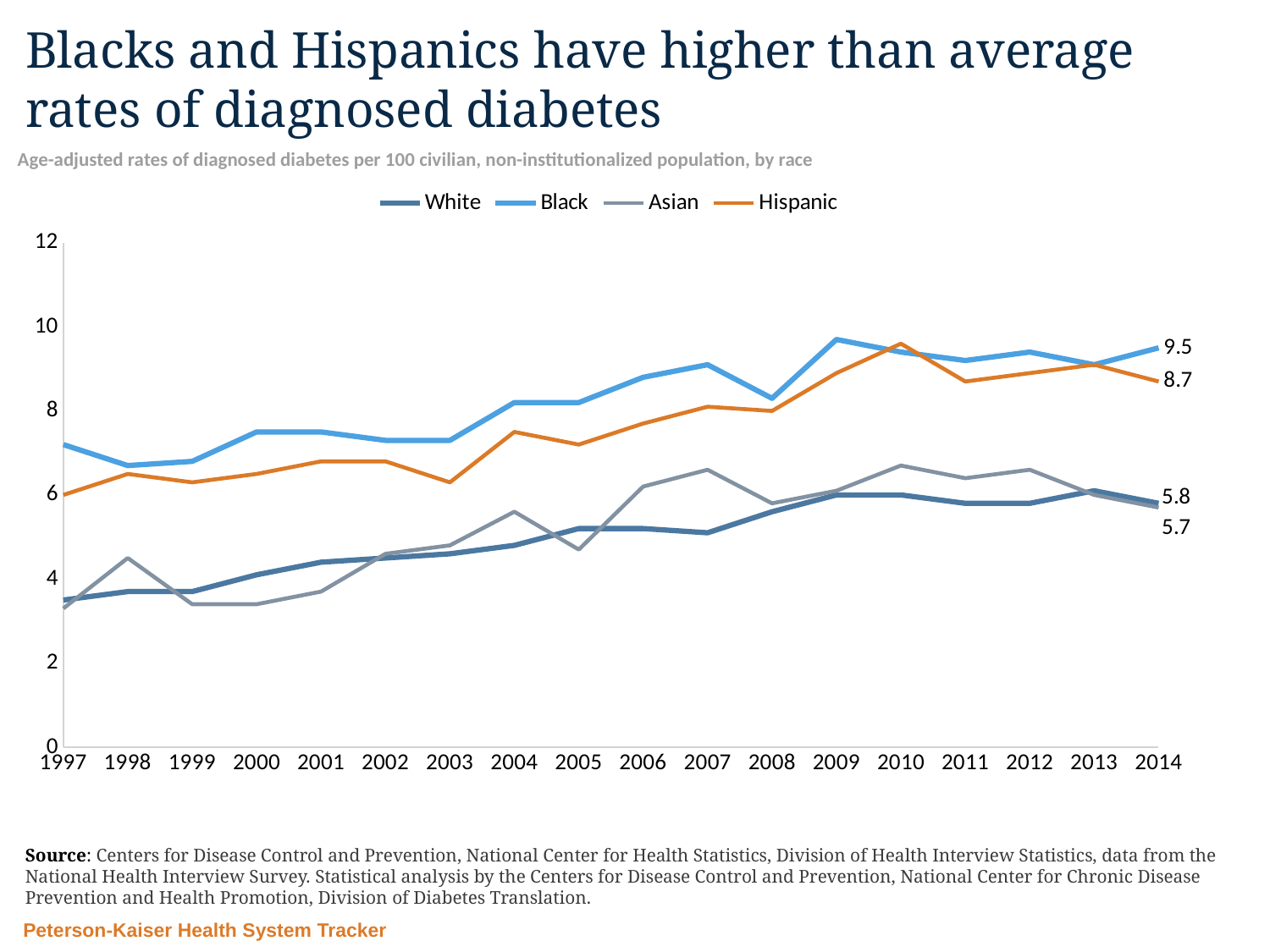
What kind of chart is shown on the slide? line chart What is the difference between the Black and Hispanic rates in 2014? 0.8 What is the rate of diagnosed diabetes for White in 2014? 5.8 What is the rate of diagnosed diabetes for Black in 2014? 9.5 What is the rate of diagnosed diabetes for Hispanic in 2014? 8.7 Is the value for White in 1997 greater or less than 4? less How many years are plotted along the x axis? 18 In 2014, which is larger, the rate for Black or the rate for Hispanic? Black Does the White line generally rise or fall from 1997 to 2014? rise How many series does the legend list? 4 Is the value for Black in 2009 greater or less than 8? greater Which group has the highest rate of diagnosed diabetes in 2014? Black